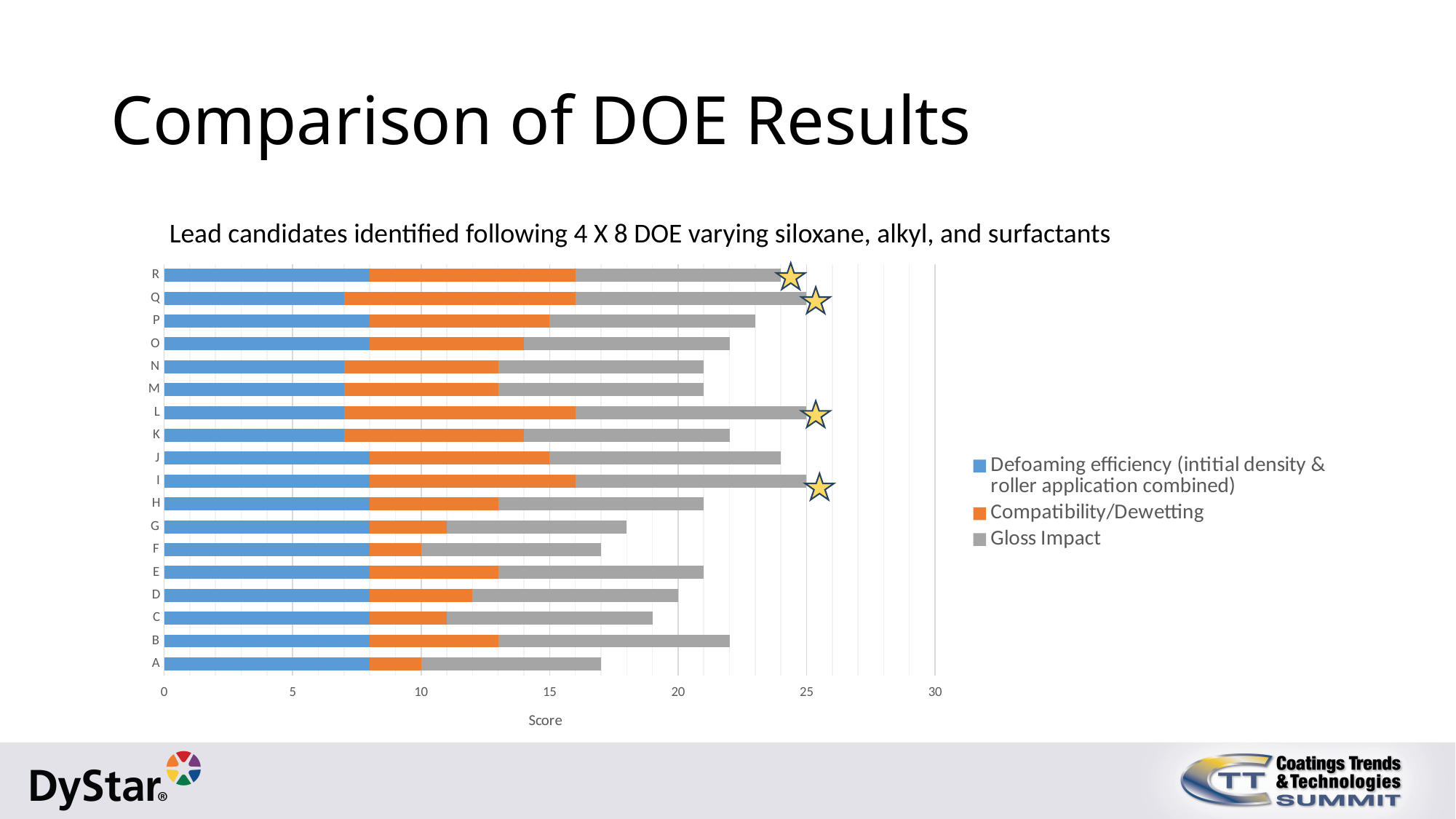
Is the total score for candidate G greater or less than 20? less How many series does the legend list? 3 How many candidate categories (A through R) are plotted on the chart? 18 Which has the larger Compatibility/Dewetting value, candidate L or candidate F? L Which has the larger total score, candidate J or candidate H? J Is the Defoaming efficiency value for candidate A greater or less than 5? greater Is the total score for candidate A greater or less than 20? less What is the title of the horizontal axis? Score What is the total score for candidate D? 20 Which colour represents Gloss Impact in the legend? gray What kind of chart is shown on the slide? bar chart